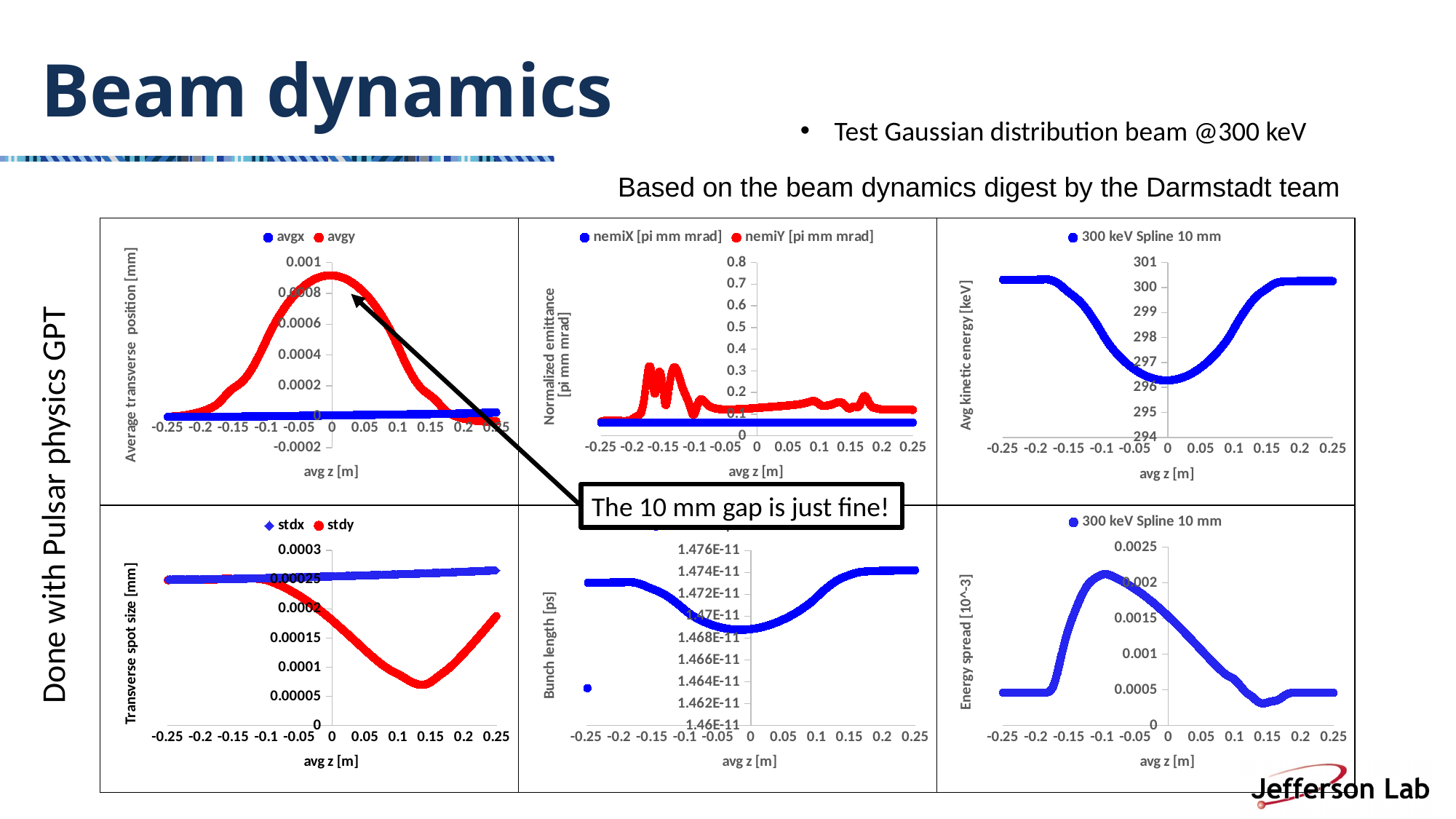
In the bottom-left chart (Transverse spot size), which series is larger at avg z = 0.15, stdx or stdy? stdx In the bottom-left chart (Transverse spot size), is the minimum of stdy greater or less than 0.0001? less In the top-left chart (Average transverse position), which series is larger at avg z = 0, avgx or avgy? avgy In the bottom-right chart (Energy spread), is the peak value greater or less than 0.0015? greater In the bottom-middle chart (Bunch length), is the value at avg z = 0.25 greater or less than 1.472E-11? greater How many series does the legend of the top-left chart (Average transverse position) list? 2 What are the two series named in the legend of the bottom-left chart (Transverse spot size)? stdx and stdy In the top-right chart (Avg kinetic energy), does the value rise or fall as avg z goes from -0.25 to 0? fall What is the x-axis title of the top-right chart (Avg kinetic energy)? avg z [m]